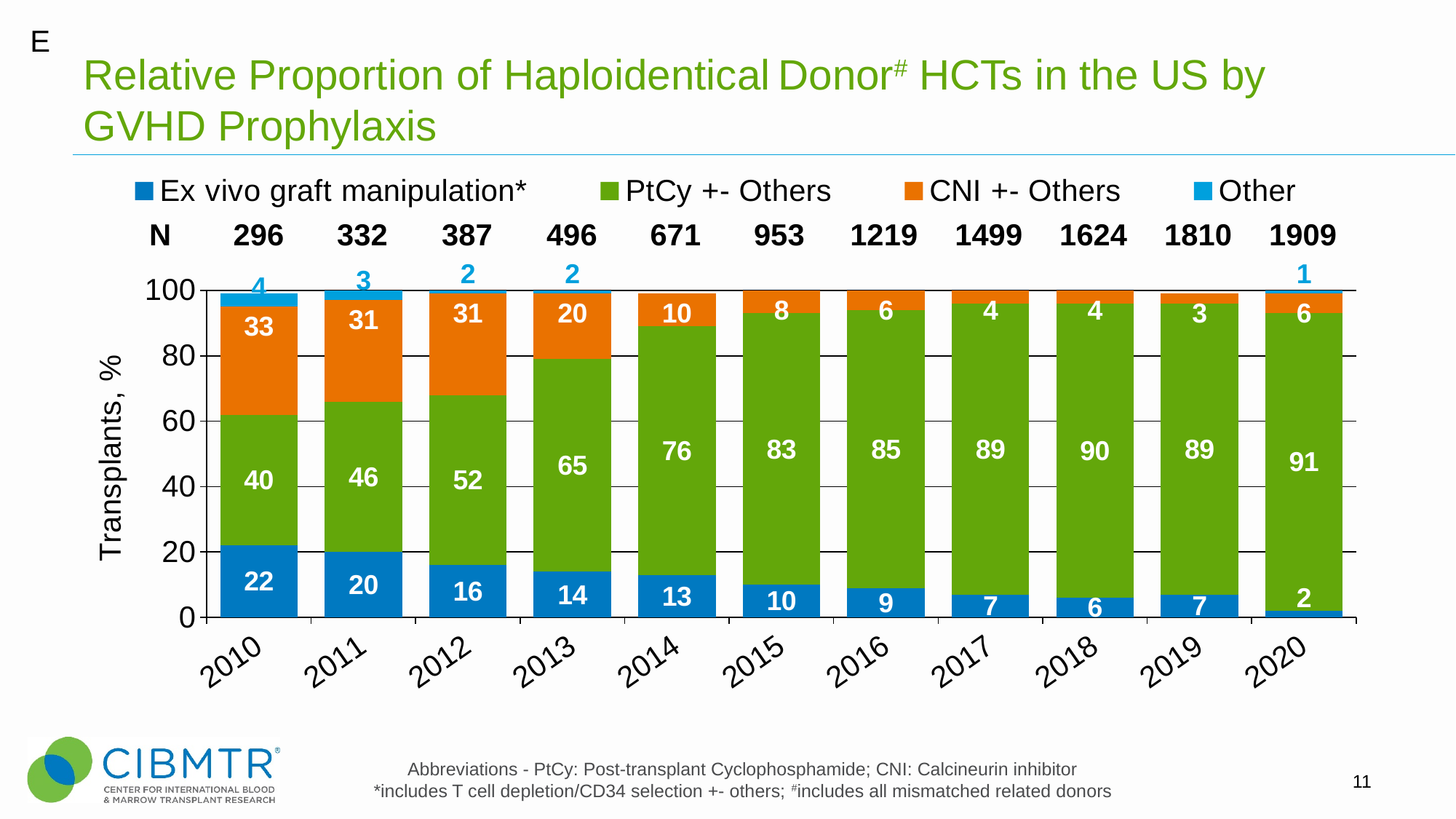
How many years are shown on the x axis? 11 What is the value for CNI +- Others in 2013? 20 What is the difference between the PtCy +- Others value in 2020 and in 2010? 51 Does the PtCy +- Others proportion generally rise or fall from 2010 to 2020? Rise In which year is the Ex vivo graft manipulation* proportion lowest? 2020 In which year is the PtCy +- Others proportion highest? 2020 How many series does the legend list? 4 What is the N shown for 2017? 1499 What kind of chart is shown? Stacked bar chart What percentage of transplants used PtCy +- Others in 2010? 40 What is the value for Ex vivo graft manipulation* in 2020? 2 Which is larger, the CNI +- Others value in 2010 or in 2020? 2010